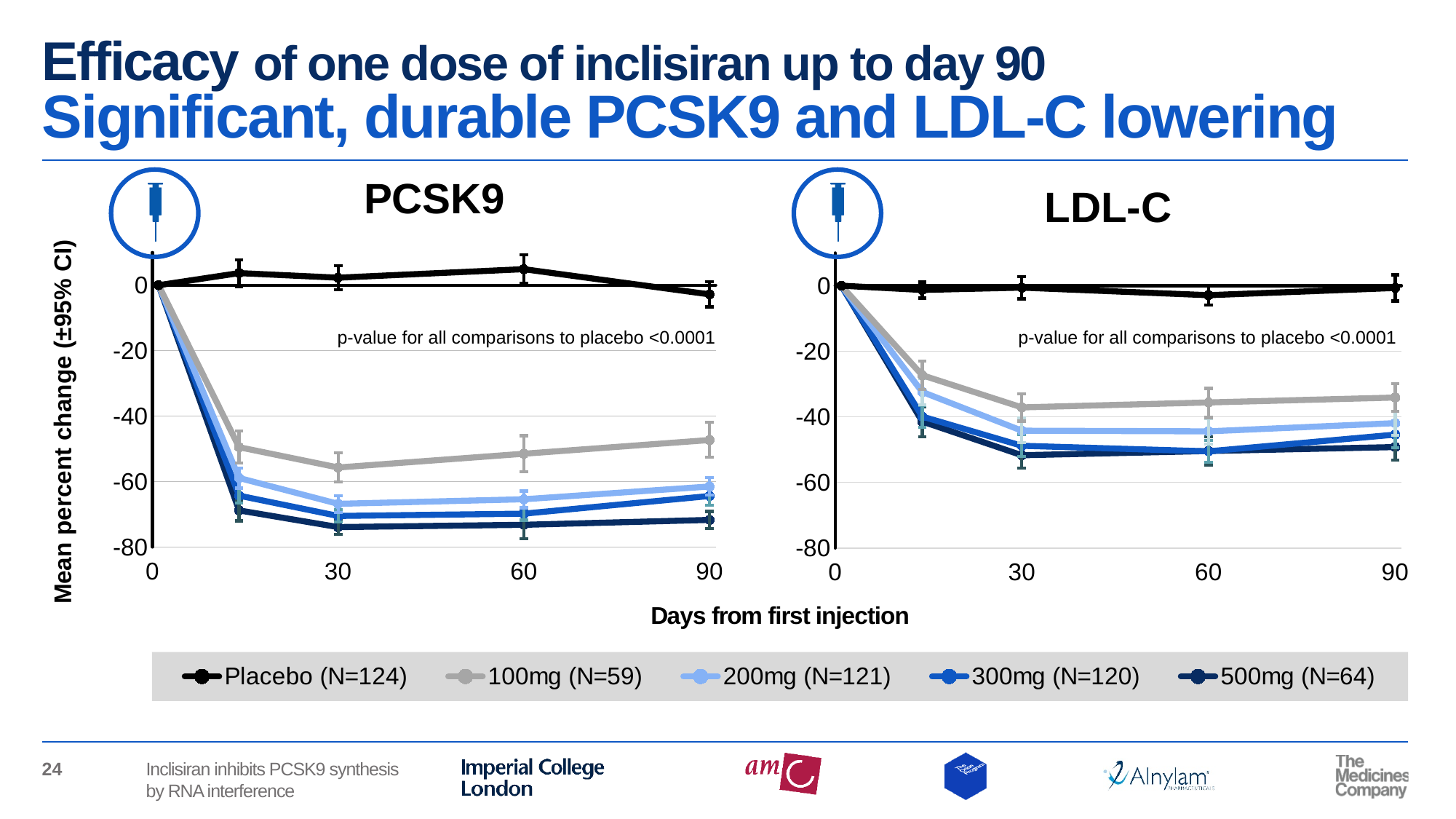
In the PCSK9 chart at day 90, which is higher: 100mg (N=59) or 500mg (N=64)? 100mg (N=59) In the PCSK9 chart, is the value for 100mg (N=59) at day 30 greater or less than -40? less What is the x-axis label shared by both charts? Days from first injection In the LDL-C chart at day 30, which is higher: 100mg (N=59) or 300mg (N=120)? 100mg (N=59) In the PCSK9 chart, which series has the highest value at day 60? Placebo (N=124) How many series does the legend list? 5 In the PCSK9 chart, does the 100mg (N=59) series rise or fall from day 30 to day 90? Rise In the PCSK9 chart, which series has the lowest value at day 30? 500mg (N=64) What kind of chart is the PCSK9 chart? Line chart In the LDL-C chart, is the value for 500mg (N=64) at day 30 greater or less than -40? less In the PCSK9 chart, is the value for 500mg (N=64) at day 30 greater or less than -60? less